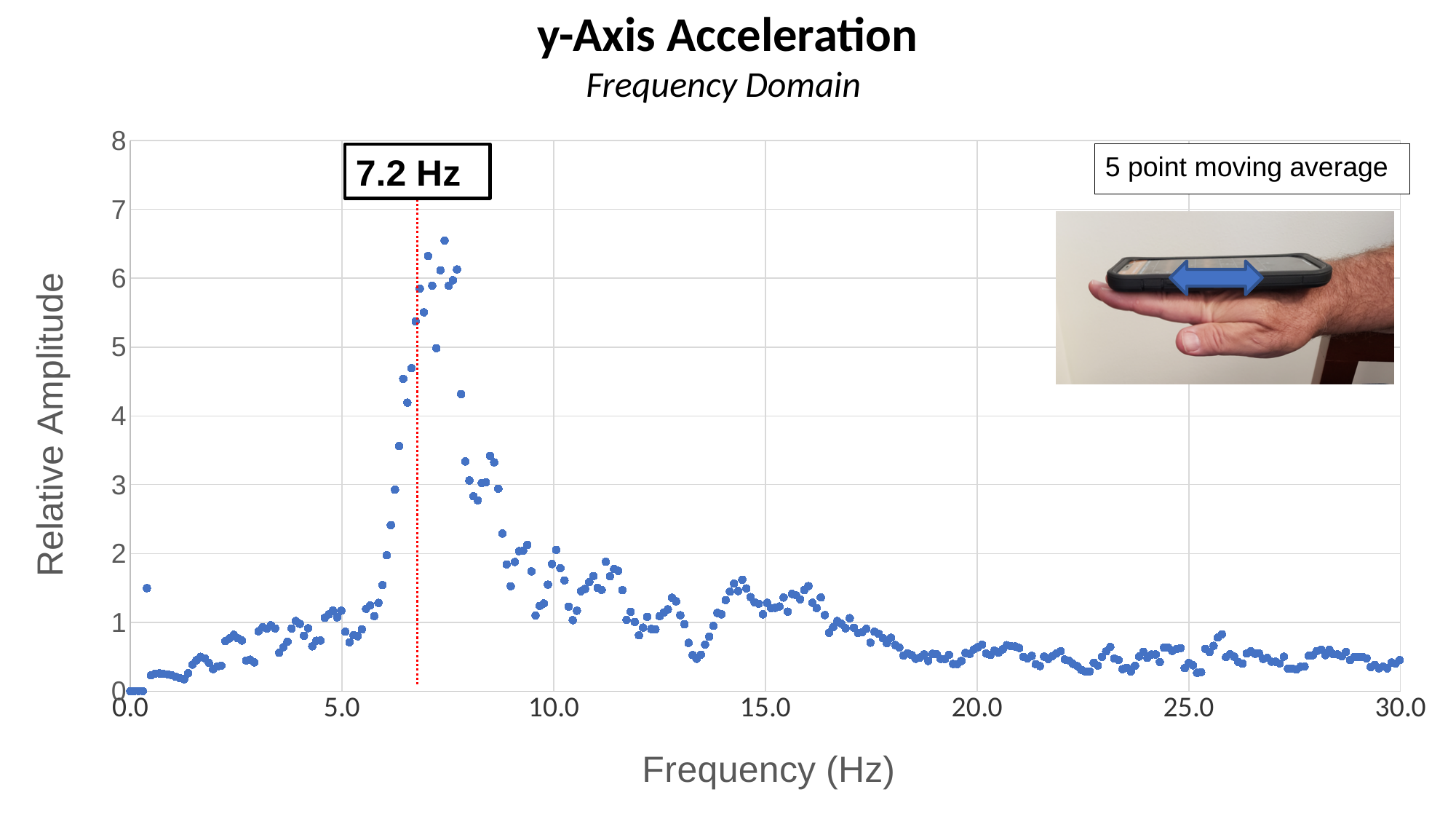
Is the relative amplitude at 10.0 Hz greater or less than 3? less What kind of chart is shown on the slide? scatter chart Is the relative amplitude at 20.0 Hz greater or less than 1? less Between 5.0 Hz and 7.2 Hz, does the relative amplitude generally rise or fall as frequency increases? rise Is the highest relative amplitude on the chart greater or less than 6? greater Which has the larger relative amplitude: the point at 7.2 Hz or the point at 15.0 Hz? 7.2 Hz Which has the larger relative amplitude: the point at 10.0 Hz or the point at 25.0 Hz? 10.0 Hz What frequency is marked by the annotation and red dotted line on the chart? 7.2 Hz What is the title of the chart? y-Axis Acceleration Between 7.2 Hz and 10.0 Hz, does the relative amplitude generally rise or fall as frequency increases? fall